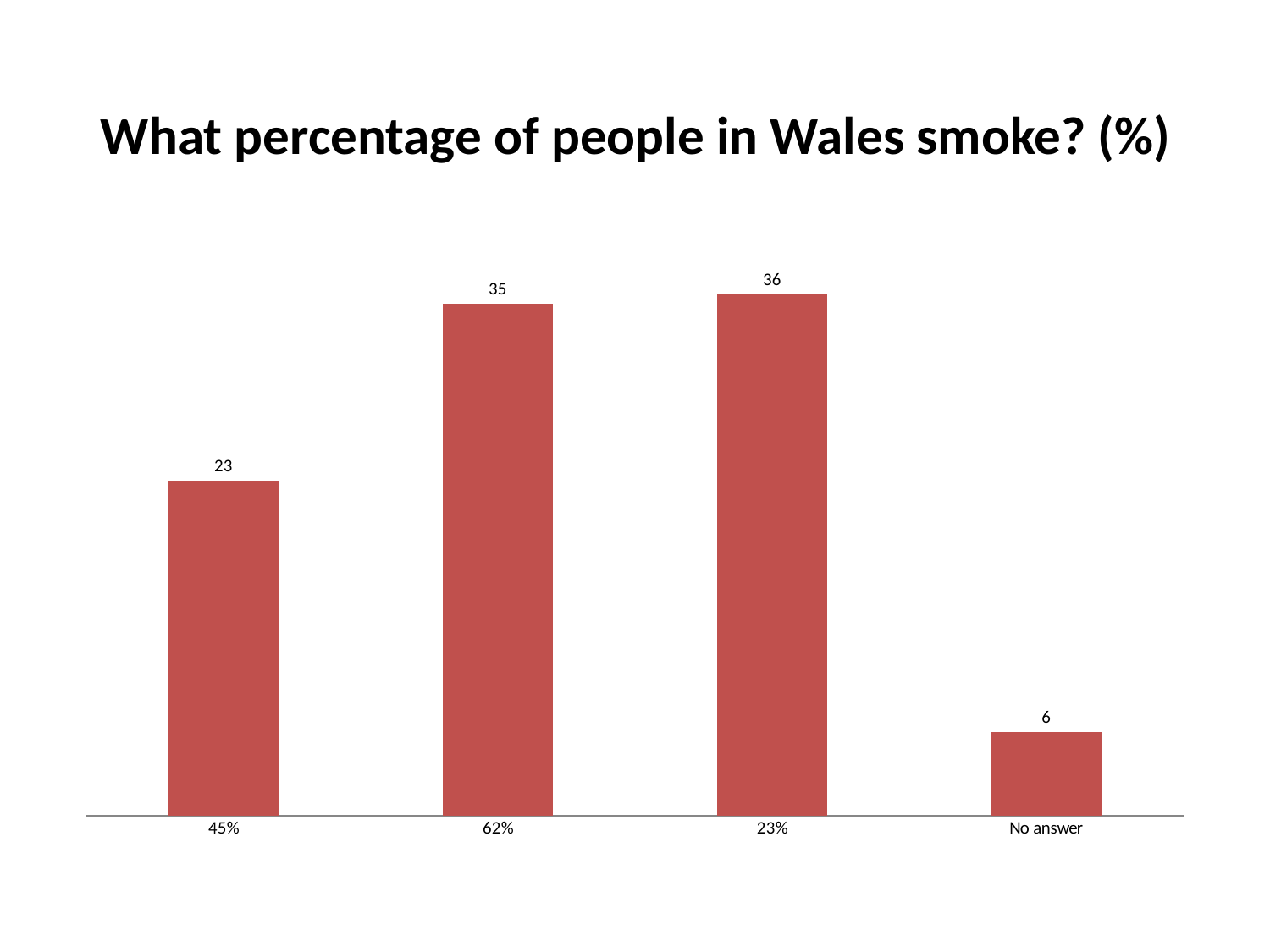
What is the value for the "23%" category? 36 What is the value for the "62%" category? 35 What is the value for the "45%" category? 23 How many categories are shown on the x axis? 4 What is the title of the chart? What percentage of people in Wales smoke? (%) What is the difference between the values for "62%" and "45%"? 12 Which category has the lowest value? No answer Which is larger, the value for "45%" or the value for "No answer"? 45% What kind of chart is shown on the slide? Bar chart Which is larger, the value for "62%" or the value for "45%"? 62% What is the value for the "No answer" category? 6 What is the difference between the values for "23%" and "No answer"? 30